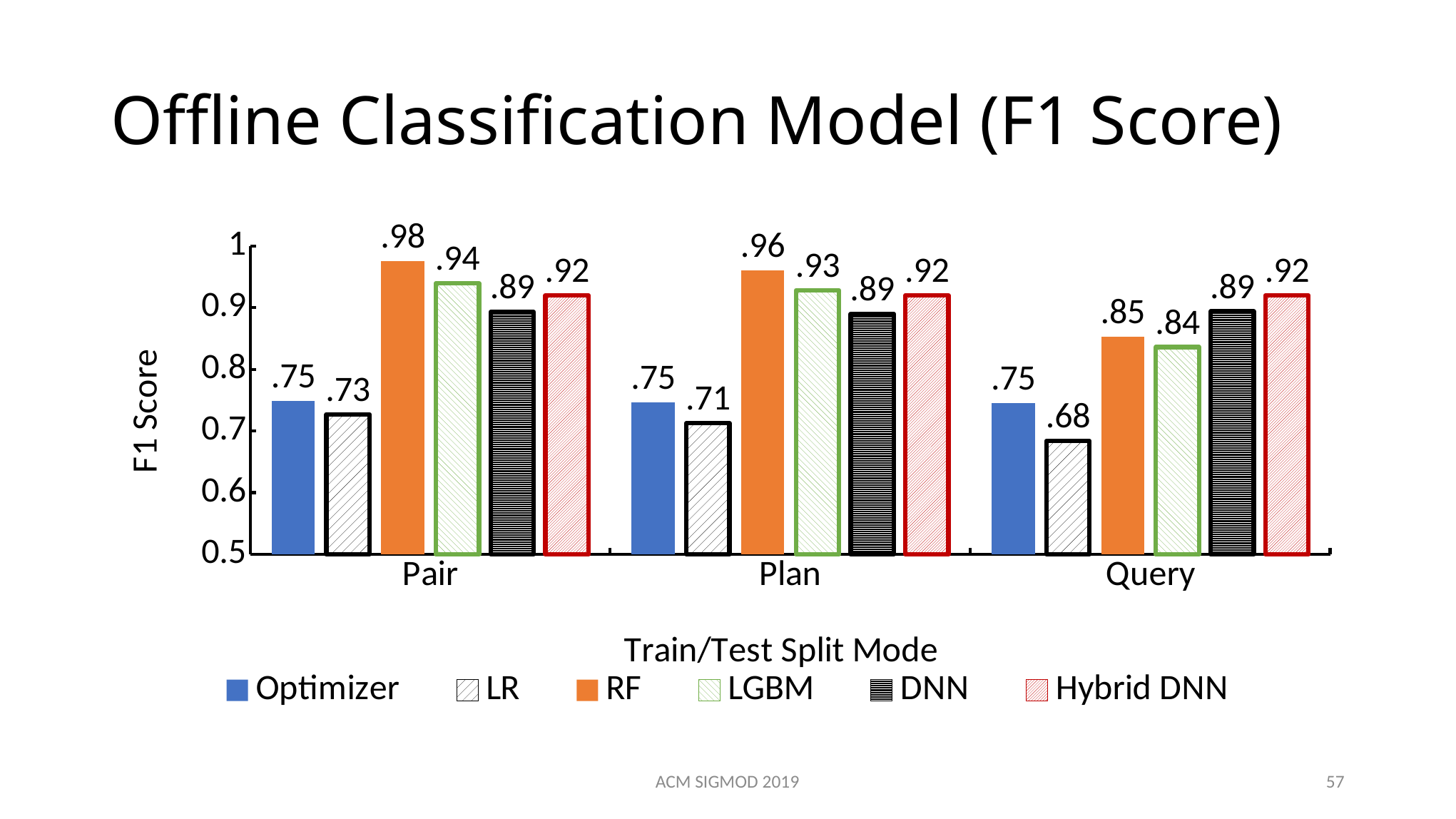
Which model has the lowest F1 score for the Plan split mode? LR How many series does the legend list? 6 What is the label of the y axis? F1 Score What is the F1 score of RF for the Pair split mode? .98 What kind of chart is shown on the slide? bar chart Which model has the highest F1 score for the Query split mode? Hybrid DNN Is the F1 score of LGBM for the Query split mode greater or less than 0.9? less How many train/test split modes are shown on the x axis? 3 What is the F1 score of Hybrid DNN for the Plan split mode? .92 Which has a higher F1 score for the Query split mode, RF or DNN? DNN What is the F1 score of LR for the Query split mode? .68 What is the difference between the F1 scores of RF and LR for the Pair split mode? .25